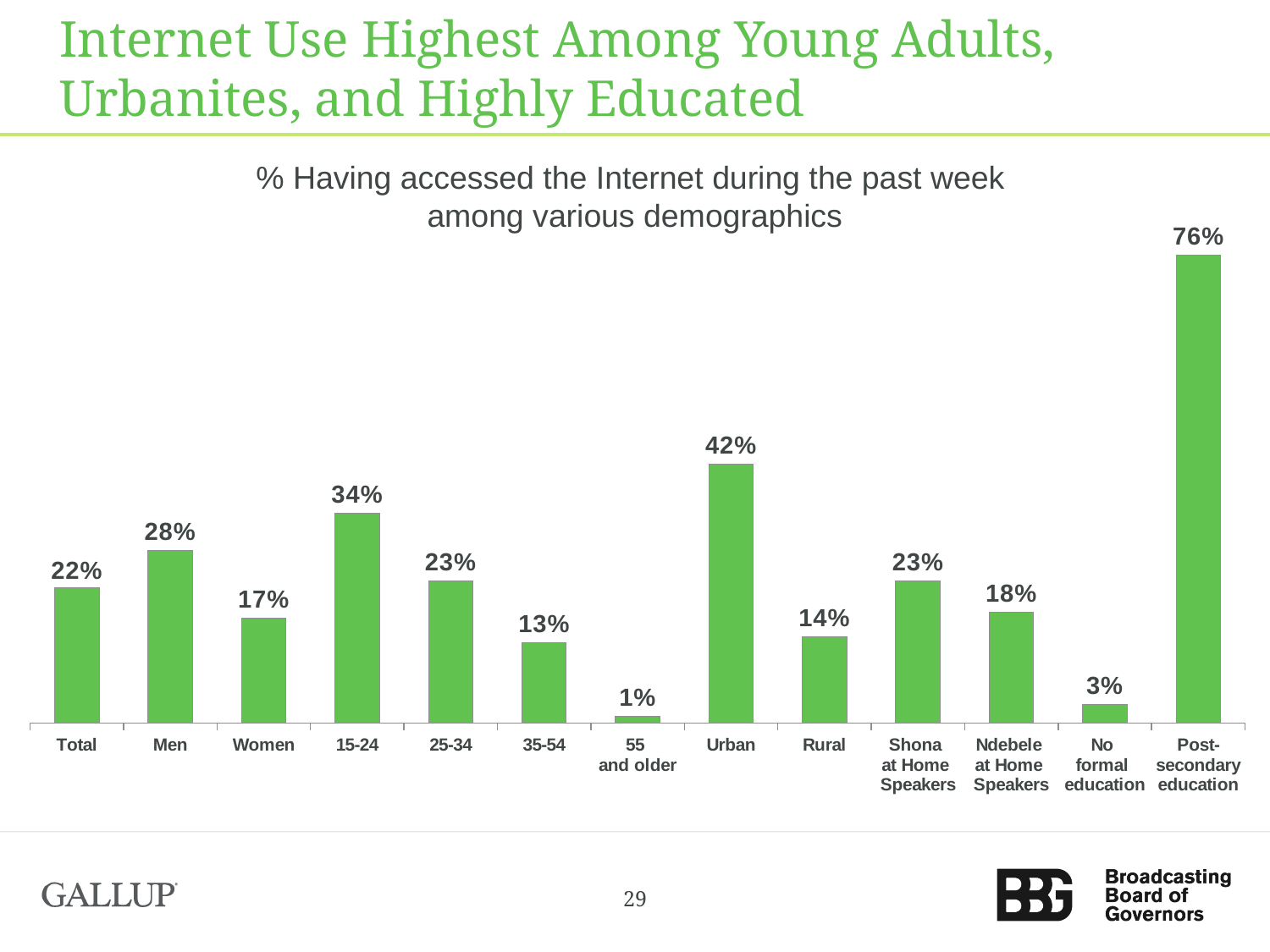
What is the value for Ndebele at Home Speakers? 18% Which category has the highest percentage of Internet access in the past week? Post-secondary education What is the difference between the values for Men and Women? 11% What percentage of Urban respondents accessed the Internet during the past week? 42% Which category has the lowest percentage? 55 and older How many categories are shown on the chart? 13 What kind of chart is shown on the slide? Bar chart Which is larger, the value for Shona at Home Speakers or for Ndebele at Home Speakers? Shona at Home Speakers What is the value for the Total category? 22% What is the difference between the Urban and Rural values? 28% Do the values rise or fall across the age groups from 15-24 to 55 and older? Fall What is the value shown for the 15-24 age group? 34%